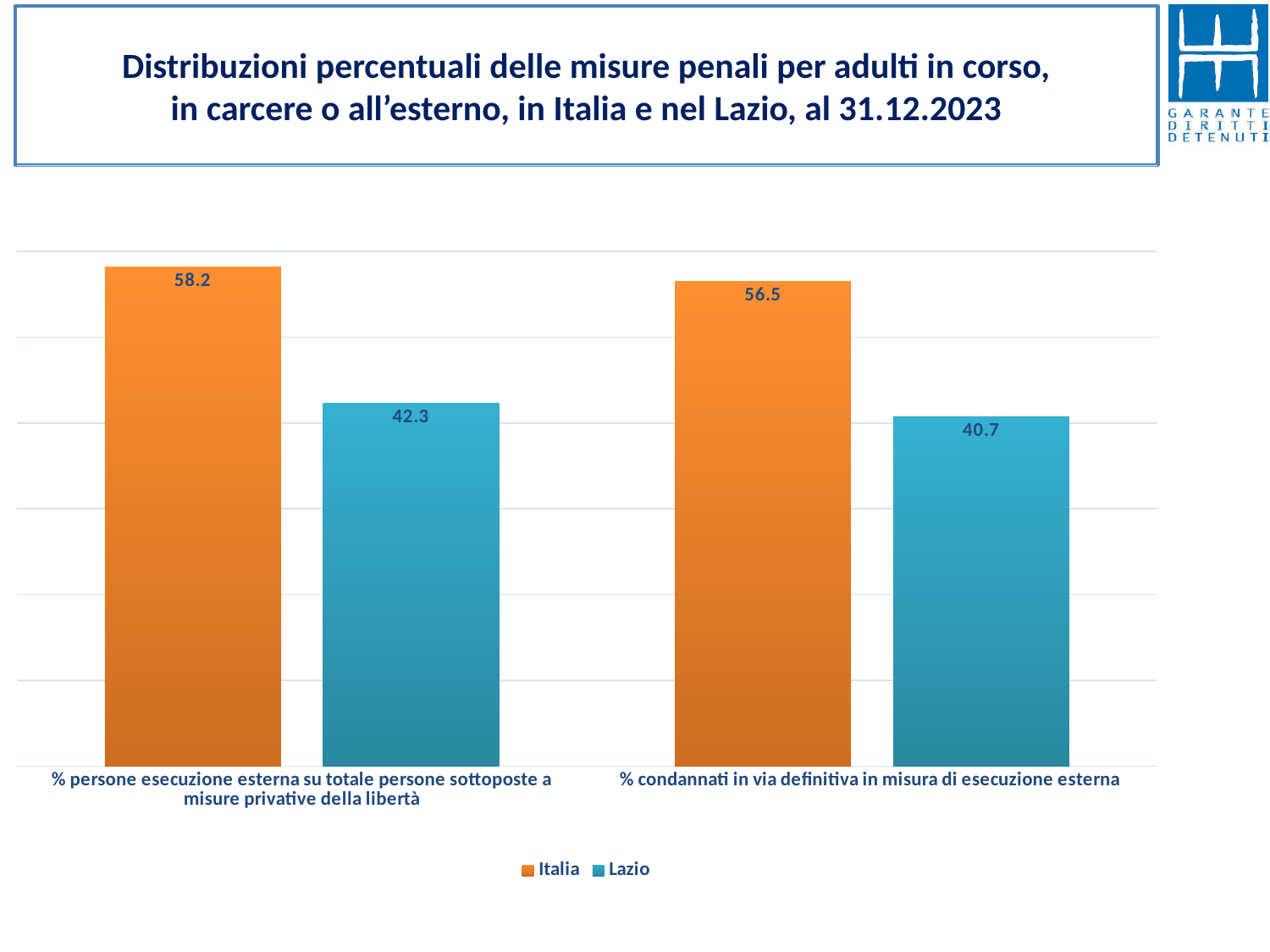
What is the value for Lazio in the category '% condannati in via definitiva in misura di esecuzione esterna'? 40.7 What is the difference between Italia and Lazio in the category '% persone esecuzione esterna su totale persone sottoposte a misure privative della libertà'? 15.9 What is the difference between Italia and Lazio in the category '% condannati in via definitiva in misura di esecuzione esterna'? 15.8 Which is larger: Italia or Lazio in the category '% condannati in via definitiva in misura di esecuzione esterna'? Italia Which bar has the lowest value in the chart? Lazio, % condannati in via definitiva in misura di esecuzione esterna Which series has the highest value in the chart? Italia How many series does the legend list? 2 What is the value for Lazio in the category '% persone esecuzione esterna su totale persone sottoposte a misure privative della libertà'? 42.3 How many categories are shown on the x axis? 2 What kind of chart is shown on the slide? Bar chart What is the value for Italia in the category '% persone esecuzione esterna su totale persone sottoposte a misure privative della libertà'? 58.2 What is the value for Italia in the category '% condannati in via definitiva in misura di esecuzione esterna'? 56.5